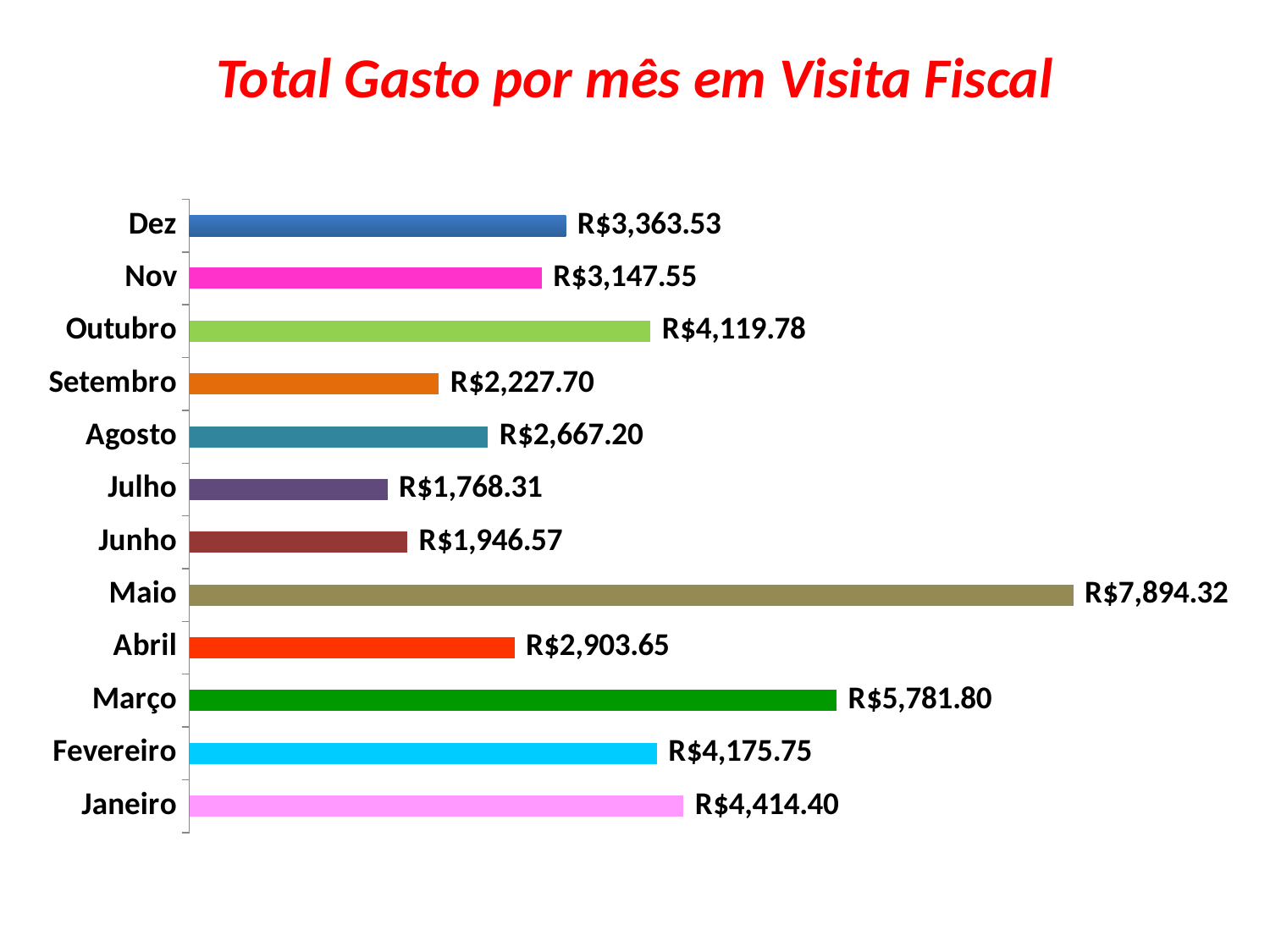
How many months are shown in the chart? 12 What is the value for Setembro? R$2,227.70 What is the difference between the values for Maio and Julho? R$6,126.01 Which is larger, the value for Agosto or the value for Fevereiro? Fevereiro What is the difference between the values for Março and Abril? R$2,878.15 What is the title of the chart? Total Gasto por mês em Visita Fiscal What is the value for Maio? R$7,894.32 What is the value for Janeiro? R$4,414.40 Which is larger, the value for Dez or the value for Nov? Dez Which month has the lowest total spent? Julho Which month has the highest total spent? Maio What kind of chart is shown on the slide? Bar chart